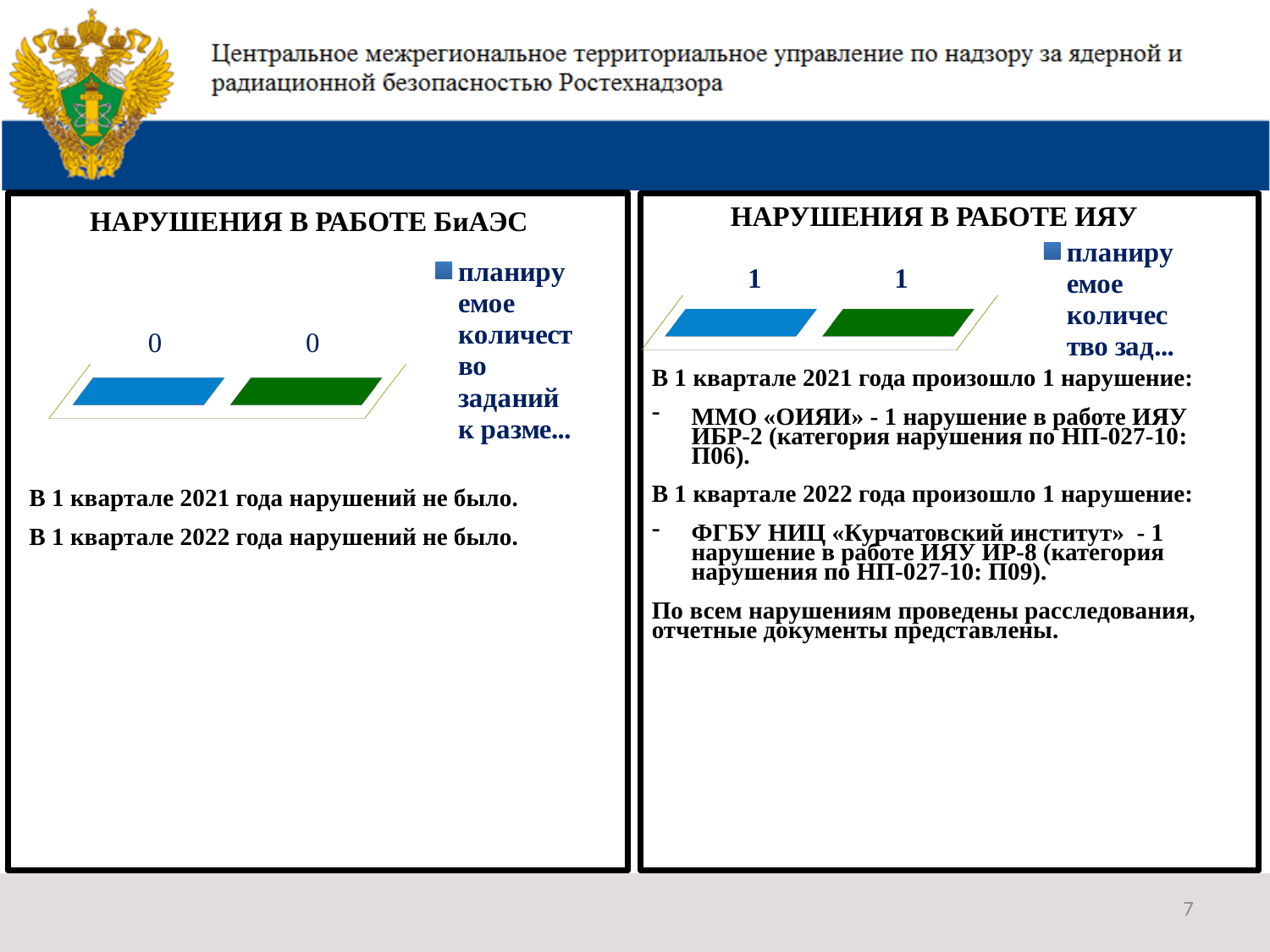
What kind of chart is the chart titled «НАРУШЕНИЯ В РАБОТЕ БиАЭС» on the left? bar chart In the chart titled «НАРУШЕНИЯ В РАБОТЕ ИЯУ» on the right, what is the difference between the value of the blue bar and the value of the green bar? 0 In the chart titled «НАРУШЕНИЯ В РАБОТЕ БиАЭС» on the left, what colour is the first (left-hand) bar? blue In the chart titled «НАРУШЕНИЯ В РАБОТЕ БиАЭС» on the left, how many bars are plotted? 2 In the chart titled «НАРУШЕНИЯ В РАБОТЕ ИЯУ» on the right, what value is labelled on the green bar? 1 In the chart titled «НАРУШЕНИЯ В РАБОТЕ БиАЭС» on the left, what value is labelled on the blue bar? 0 In the chart titled «НАРУШЕНИЯ В РАБОТЕ БиАЭС» on the left, how many entries does the legend list? 1 In the chart titled «НАРУШЕНИЯ В РАБОТЕ ИЯУ» on the right, how many entries does the legend list? 1 What kind of chart is the chart titled «НАРУШЕНИЯ В РАБОТЕ ИЯУ» on the right? bar chart In the chart titled «НАРУШЕНИЯ В РАБОТЕ ИЯУ» on the right, what value is labelled on the blue bar? 1 In the chart titled «НАРУШЕНИЯ В РАБОТЕ ИЯУ» on the right, how many bars are plotted? 2 In the chart titled «НАРУШЕНИЯ В РАБОТЕ БиАЭС» on the left, what value is labelled on the green bar? 0